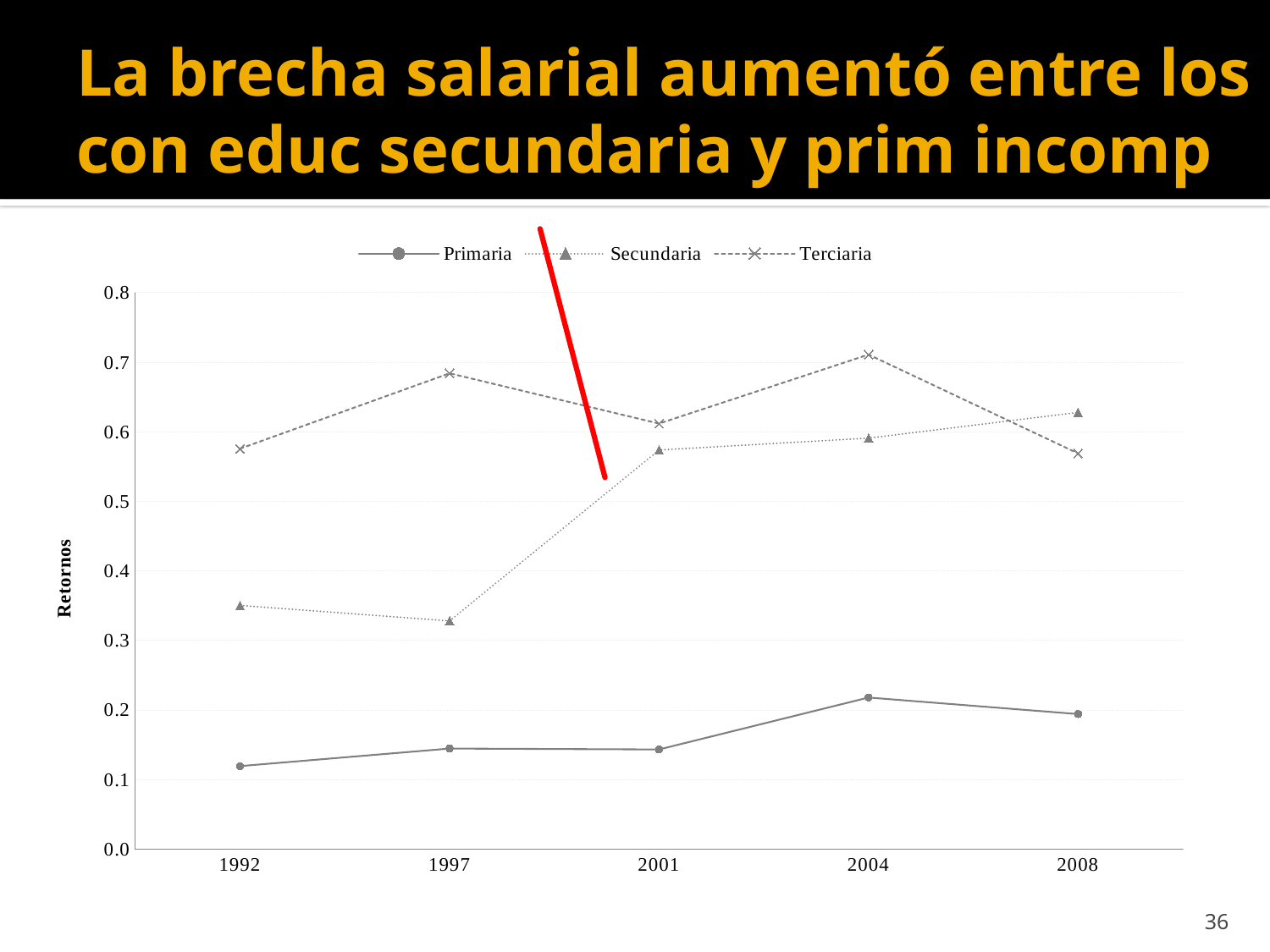
In 2008, which series has the larger value, Secundaria or Terciaria? Secundaria In which year does the Terciaria series reach its highest value? 2004 In which year is the Primaria series at its highest? 2004 In which year does the Secundaria series reach its highest value? 2008 Is the value for Secundaria in 2001 greater or less than 0.5? greater How many years are plotted along the x axis? 5 How many series does the legend list? 3 Is the value for Primaria in 2004 greater or less than 0.3? less In which year is the Primaria series at its lowest? 1992 Is the value for Terciaria in 1997 greater or less than 0.6? greater What kind of chart is shown on the slide? line chart What is the label on the y axis? Retornos